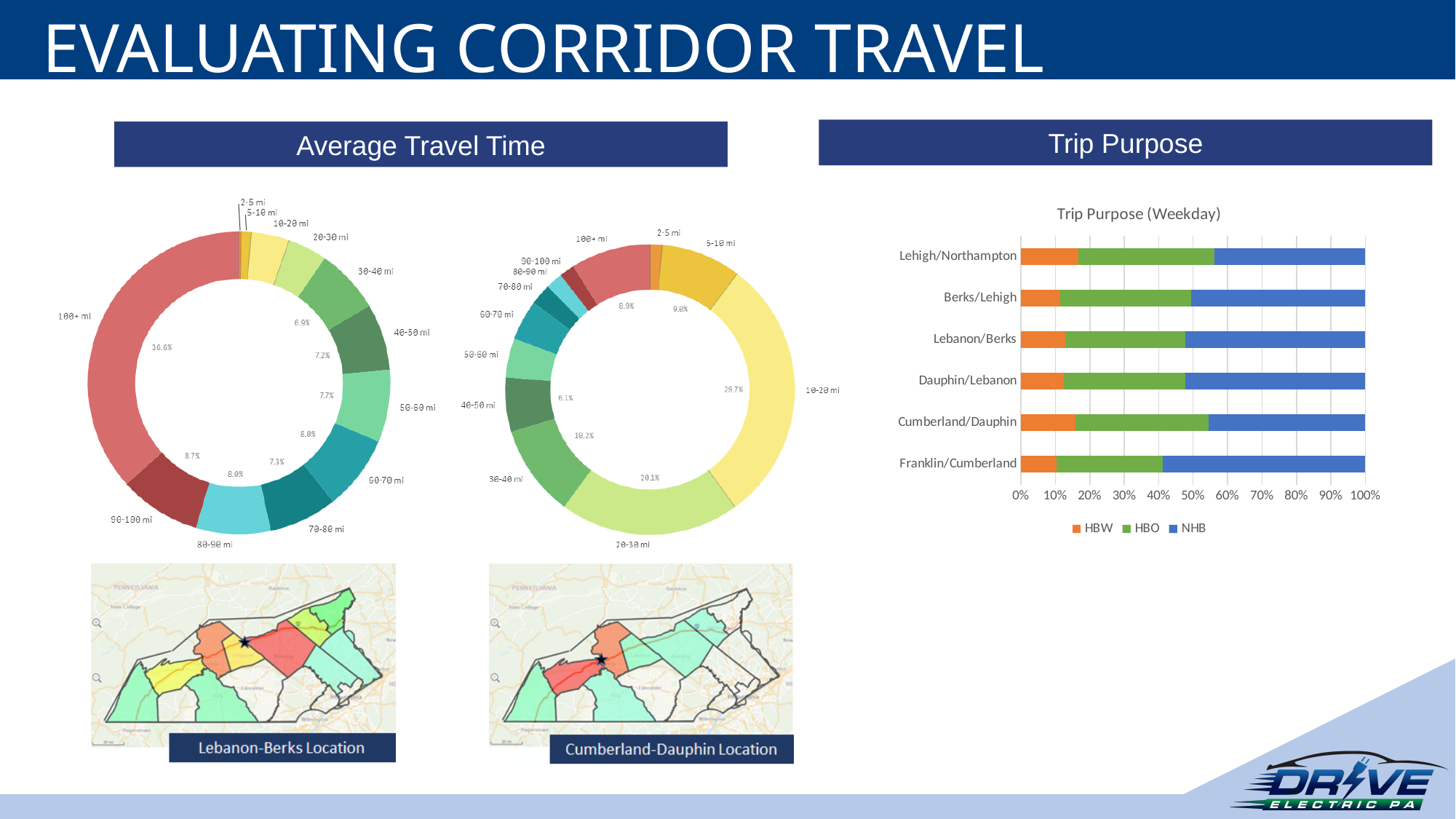
In the Cumberland-Dauphin Average Travel Time donut chart, which is larger, the 10-20 mi share or the 20-30 mi share? 10-20 mi What kind of chart is the Trip Purpose (Weekday) chart on the right? Bar chart In the Trip Purpose (Weekday) chart, is the NHB share for Franklin/Cumberland greater or less than 50%? greater In the Lebanon-Berks Average Travel Time donut chart, what is the share for 100+ mi? 36.6% How many corridors are listed on the Trip Purpose (Weekday) chart? 6 In the Trip Purpose (Weekday) chart, which corridor has the largest NHB share? Franklin/Cumberland In the Lebanon-Berks Average Travel Time donut chart, which distance band has the largest share? 100+ mi How many series does the legend of the Trip Purpose (Weekday) chart list? 3 What are the legend entries of the Trip Purpose (Weekday) chart? HBW, HBO, NHB In the Cumberland-Dauphin Average Travel Time donut chart, what is the share for 20-30 mi? 20.1% In the Cumberland-Dauphin Average Travel Time donut chart, what is the share for 10-20 mi? 29.7% In the Trip Purpose (Weekday) chart, is the HBW share for Franklin/Cumberland greater or less than 20%? less